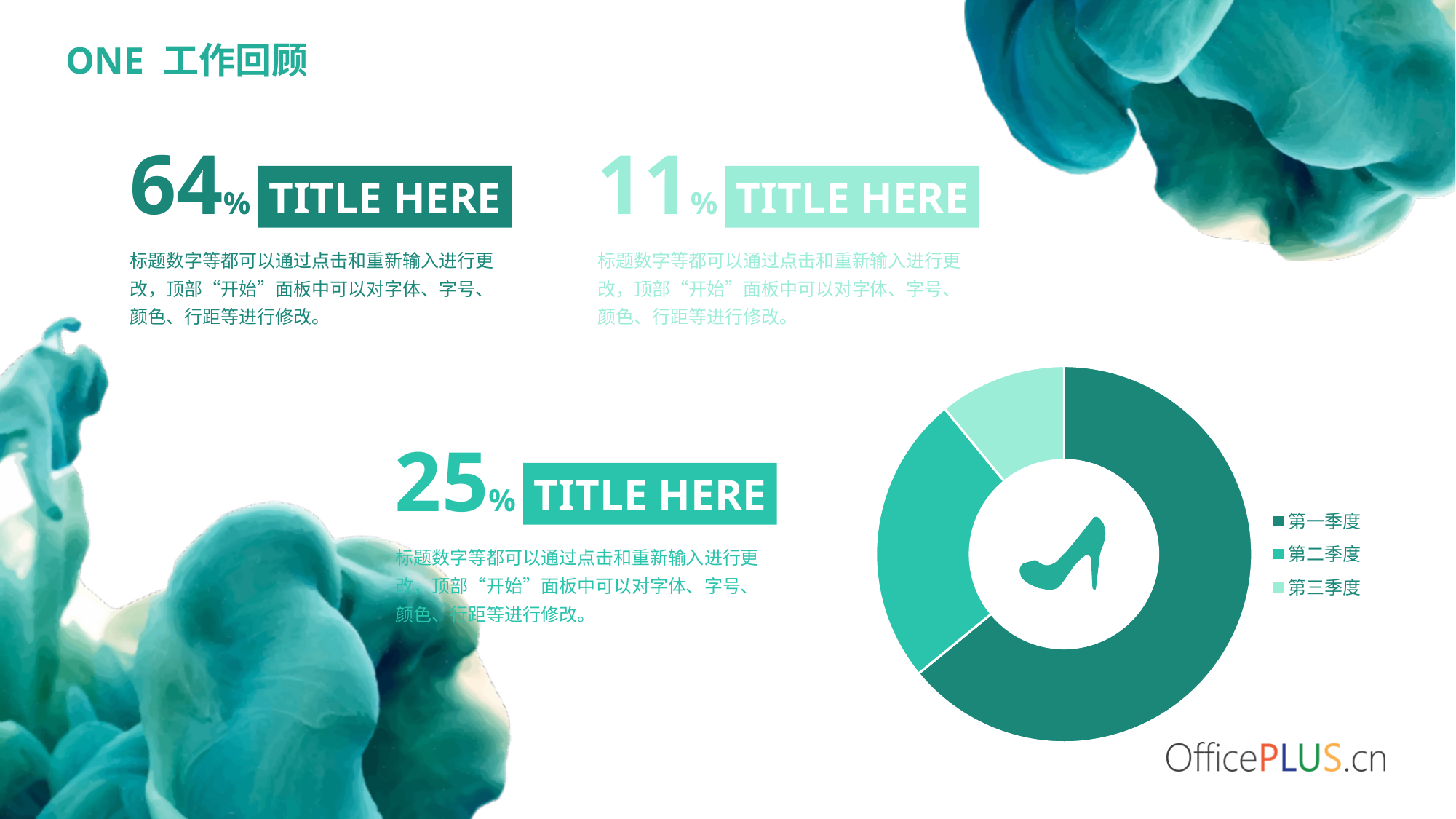
How many slices does the donut chart have? 3 Which category has the smallest slice in the donut chart? 第三季度 In the donut chart, which slice is larger: 第一季度 or 第二季度? 第一季度 What icon is shown in the centre of the donut chart? A high-heeled shoe Does the 第一季度 slice take up more or less than half of the donut chart? more How many entries does the legend of the donut chart list? 3 What is the first entry listed in the donut chart's legend? 第一季度 In the donut chart, which slice is larger: 第二季度 or 第三季度? 第二季度 Which category has the largest slice in the donut chart? 第一季度 What kind of chart is shown on the slide? Donut chart